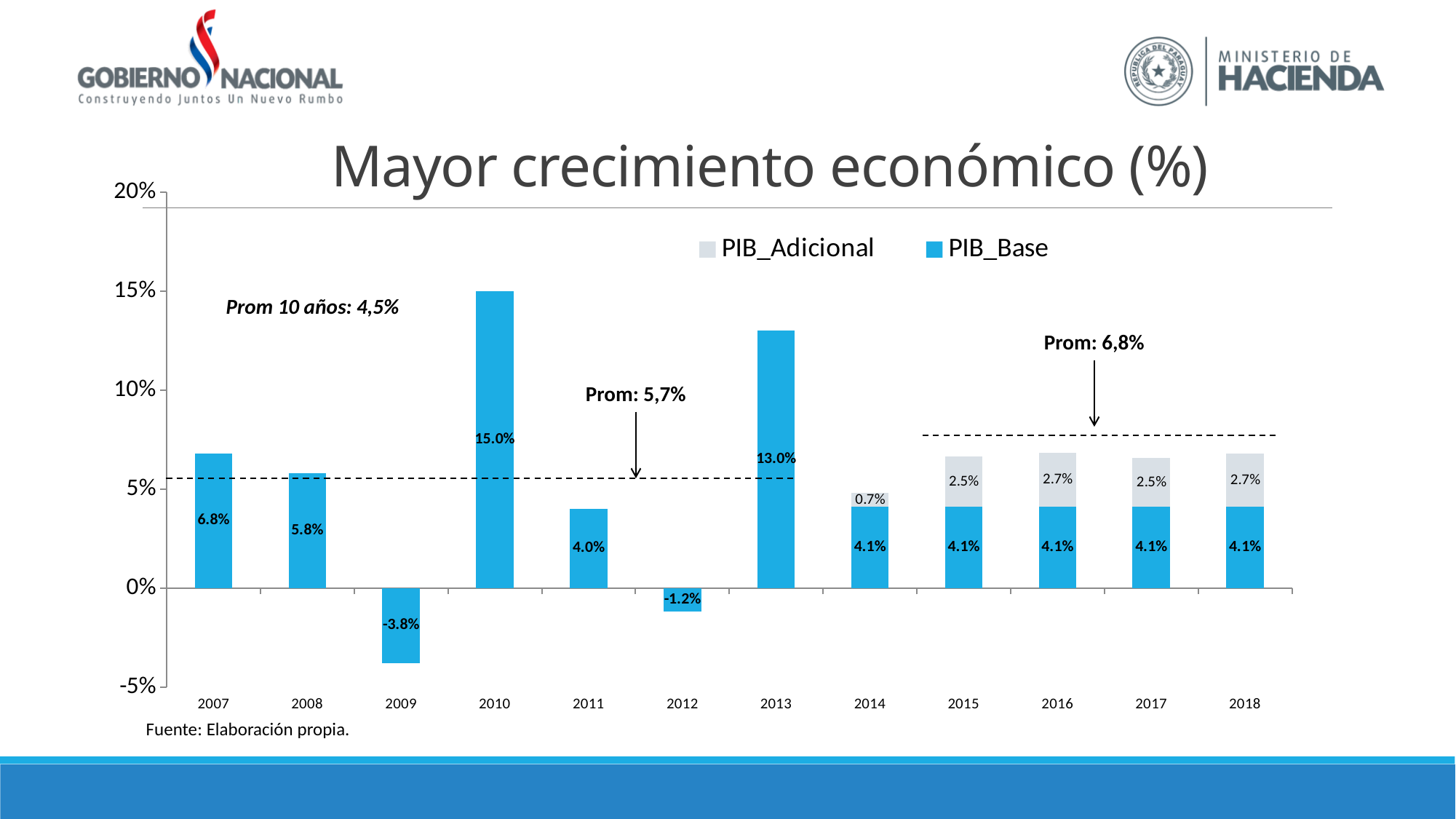
How many series does the legend list? 2 How many years are shown on the x axis? 12 What is the total of the stacked bar for 2015 (PIB_Base plus PIB_Adicional)? 6.6% What is the difference between the PIB_Base values for 2010 and 2013? 2.0% What is the PIB_Base value for 2009? -3.8% Which is larger, the PIB_Base value for 2007 or for 2008? 2007 What is the total of the stacked bar for 2014 (PIB_Base plus PIB_Adicional)? 4.8% Which year has the highest PIB_Base value? 2010 What type of chart is shown on the slide? Stacked bar chart What is the PIB_Base value for 2010? 15.0% What is the PIB_Adicional value for 2016? 2.7% Which year has the lowest PIB_Base value? 2009